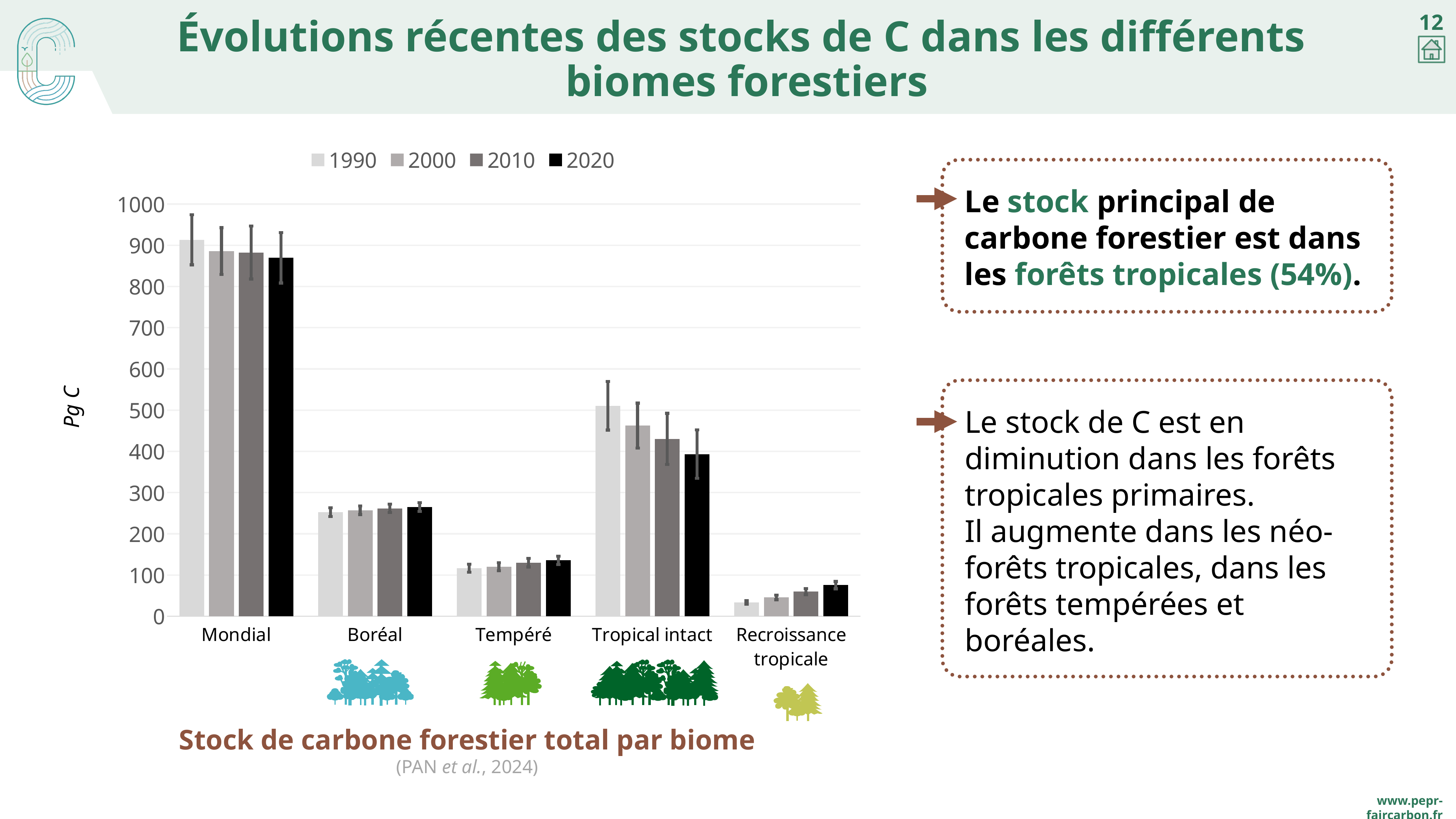
Do the values for Recroissance tropicale rise or fall from 1990 to 2020? rise What kind of chart is shown on the slide? bar chart How many series does the legend list? 4 How many biome categories are shown on the x axis? 5 Is the value for Tropical intact in 1990 greater or less than 400? greater Is the value for Mondial in 2020 greater or less than 800? greater Which category has the lowest value for 2020? Recroissance tropicale Which category has the highest value for 2020? Mondial Do the values for Tropical intact rise or fall from 1990 to 2020? fall What unit is shown on the y axis of the chart? Pg C Is the value for Boréal in 2020 greater or less than 300? less Which is larger in 2020, the value for Boréal or the value for Tempéré? Boréal